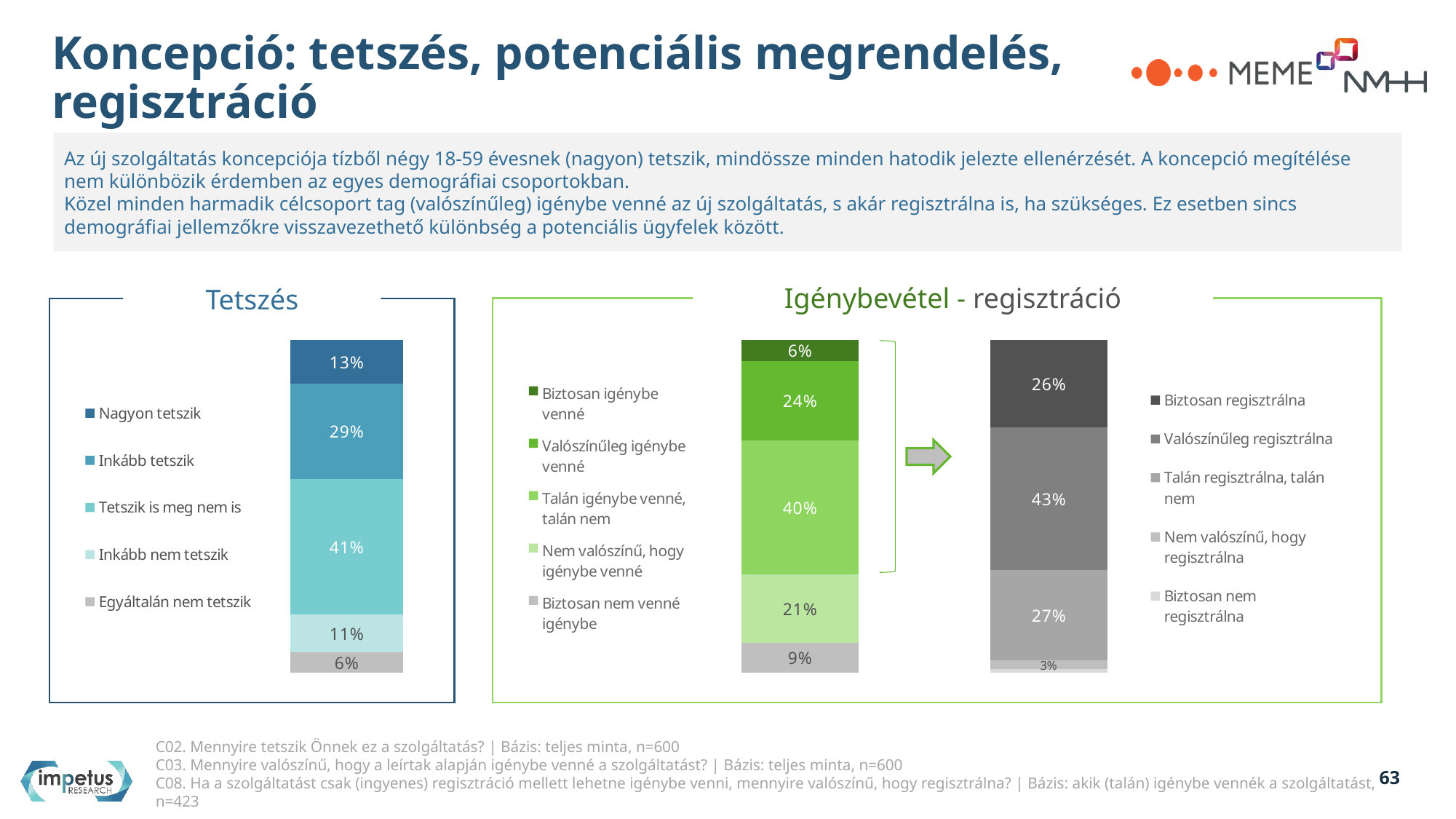
In the green Igénybevétel bar, what percentage is shown for Biztosan igénybe venné? 6% In the green Igénybevétel bar, what is the combined share of Biztosan igénybe venné and Valószínűleg igénybe venné? 30% What type of chart is used in the Tetszés panel? Stacked bar chart In the Tetszés chart, what is the difference between Inkább tetszik and Inkább nem tetszik? 18 percentage points In the grey regisztráció bar, which is larger: Biztosan regisztrálna or Talán regisztrálna, talán nem? Talán regisztrálna, talán nem In the grey regisztráció bar, what percentage is shown for Valószínűleg regisztrálna? 43% In the grey regisztráció bar, what percentage is shown for Nem valószínű, hogy regisztrálna? 3% In the Tetszés chart, which category has the smallest share? Egyáltalán nem tetszik In the green Igénybevétel bar, which category has the largest share? Talán igénybe venné, talán nem In the Tetszés chart, what percentage is shown for Nagyon tetszik? 13% How many legend entries does the Tetszés chart list? 5 In the Tetszés chart, what percentage is shown for Tetszik is meg nem is? 41%